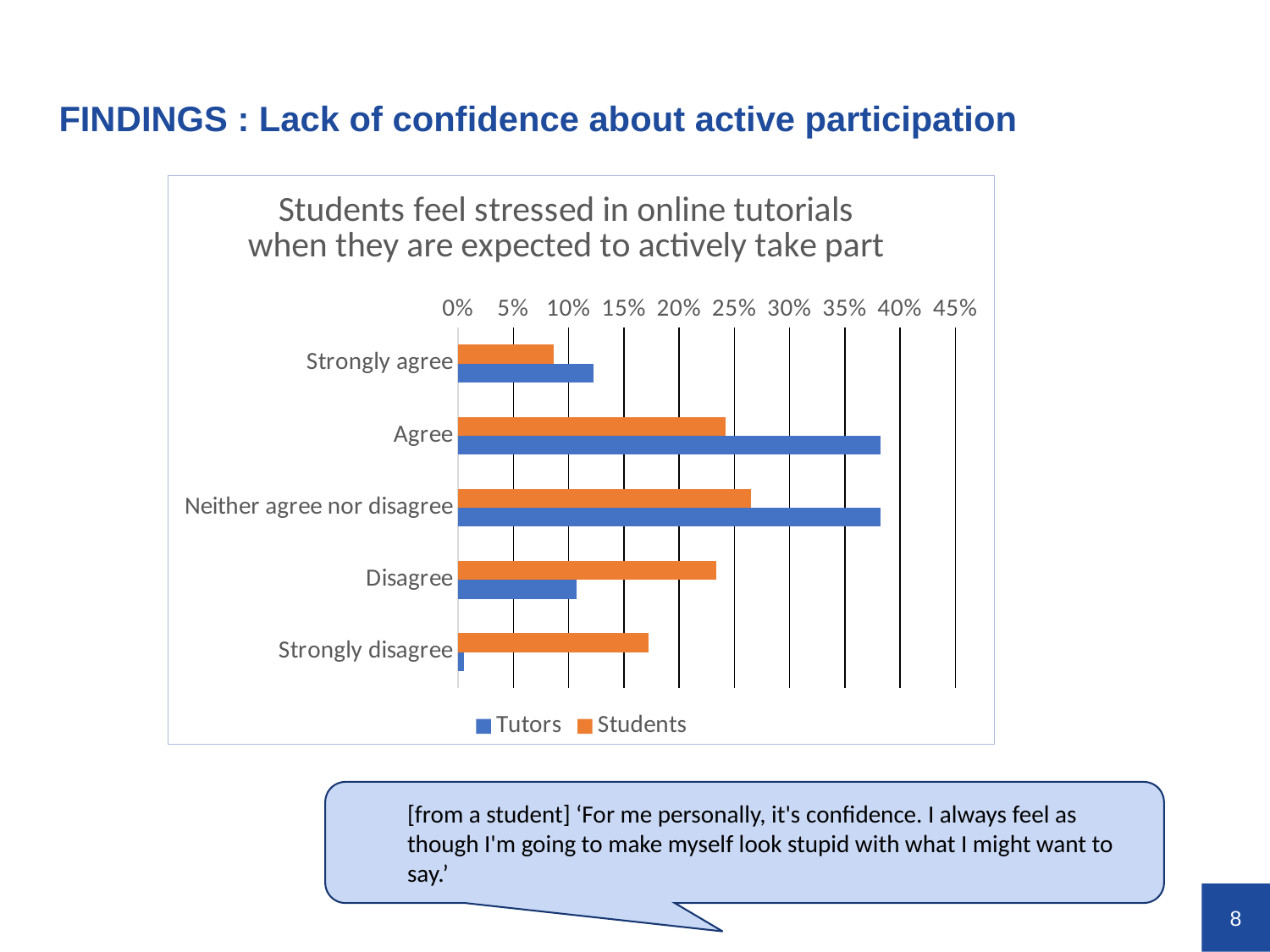
For the Tutors series, which category has the lowest value? Strongly disagree How many response categories are shown on the chart? 5 Which series is shown in orange in the chart? Students For the Students series, which category has the lowest value? Strongly agree For the Agree category, which series has the larger value, Tutors or Students? Tutors For the Disagree category, which series has the larger value, Tutors or Students? Students How many series does the chart's legend list? 2 Is the Students value for Strongly agree greater or less than 10%? less What is the title of the chart? Students feel stressed in online tutorials when they are expected to actively take part Is the Tutors value for Agree greater or less than 35%? greater Is the Students value for Strongly disagree greater or less than 15%? greater What kind of chart is shown on the slide? Bar chart